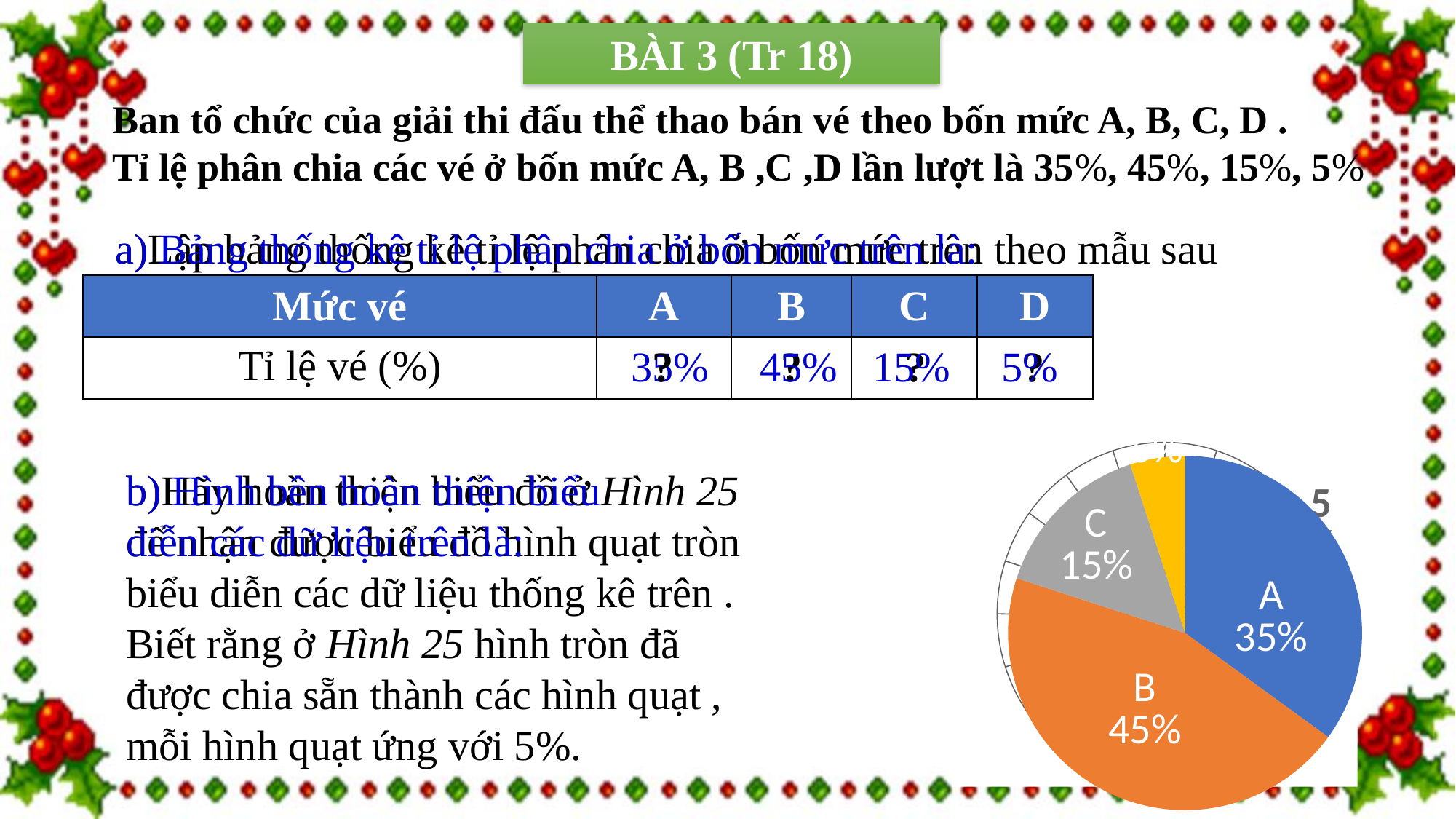
What colour is slice B in the pie chart? orange Which slice of the pie chart is the smallest? the yellow slice (D) What kind of chart is shown on the slide? pie chart What is the difference between the percentages of slices B and A in the pie chart? 10% In the pie chart, what percentage is shown for slice B? 45% How many slices does the pie chart have? 4 What colour is slice A in the pie chart? blue Which labelled slice of the pie chart is the largest? B Which is larger in the pie chart, slice A or slice C? A What is the combined percentage of slices A and B in the pie chart? 80% In the pie chart, what percentage is shown for slice C? 15% In the pie chart, what percentage is shown for slice A? 35%